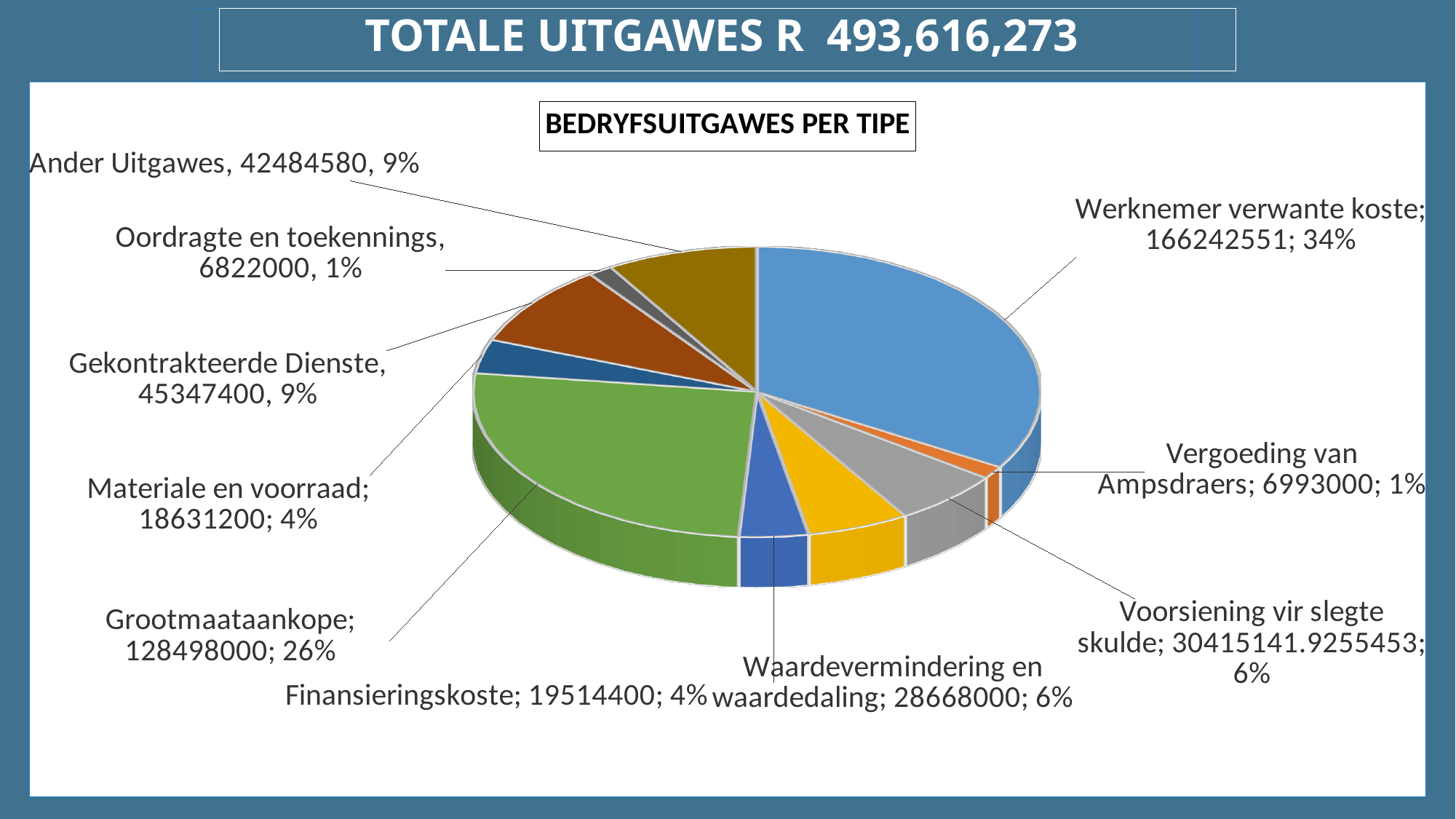
What is the value for Gekontrakteerde Dienste? 45347400 What is the title of the chart? BEDRYFSUITGAWES PER TIPE What is the difference between the values for Grootmaataankope and Gekontrakteerde Dienste? 83150600 What kind of chart is shown on the slide? Pie chart Which category has the largest slice of the pie? Werknemer verwante koste What share of the pie does Oordragte en toekennings represent? 1% What share of the pie does Voorsiening vir slegte skulde represent? 6% How many categories (slices) does the pie chart have? 10 Which is larger, Ander Uitgawes or Materiale en voorraad? Ander Uitgawes What share of the pie does Grootmaataankope represent? 26% What is the value for Werknemer verwante koste? 166242551 What is the value for Finansieringskoste? 19514400